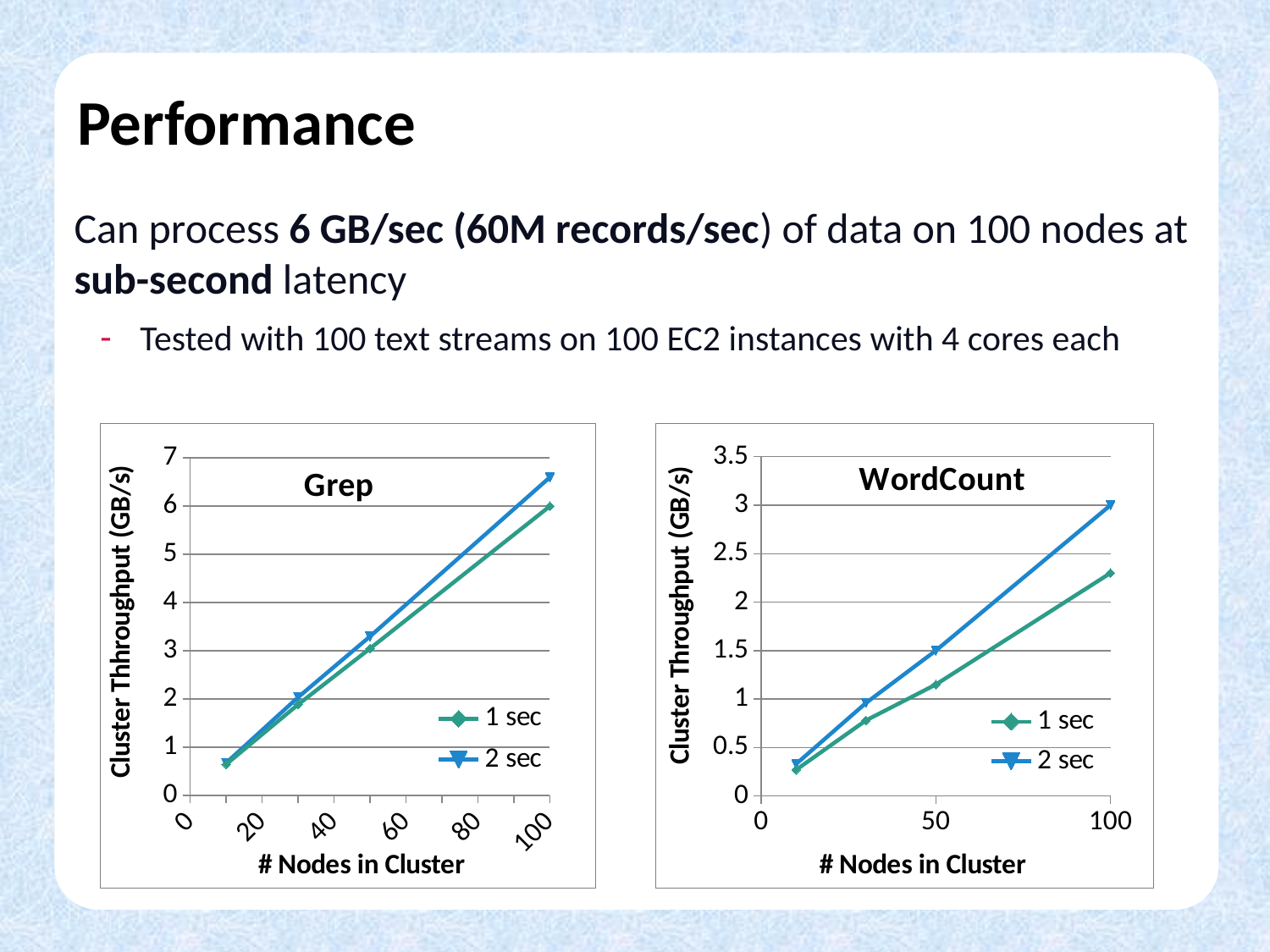
What kind of chart is the Grep chart? line chart In the Grep chart, is the 2 sec throughput at 100 nodes greater or less than 6? greater In the Grep chart, at 100 nodes, which series has the higher throughput, 1 sec or 2 sec? 2 sec In the WordCount chart, does cluster throughput rise or fall as the number of nodes increases? rise In the WordCount chart, is the 1 sec throughput at 100 nodes greater or less than 2.5? less What are the legend entries in the WordCount chart? 1 sec, 2 sec What kind of chart is the WordCount chart? line chart In the Grep chart, is the 1 sec throughput at 50 nodes greater or less than 4? less How many data points does the 1 sec series have in the Grep chart? 4 In the WordCount chart, at 50 nodes, which series has the higher throughput, 1 sec or 2 sec? 2 sec In the Grep chart, does cluster throughput rise or fall as the number of nodes increases? rise How many series does the legend of the Grep chart list? 2